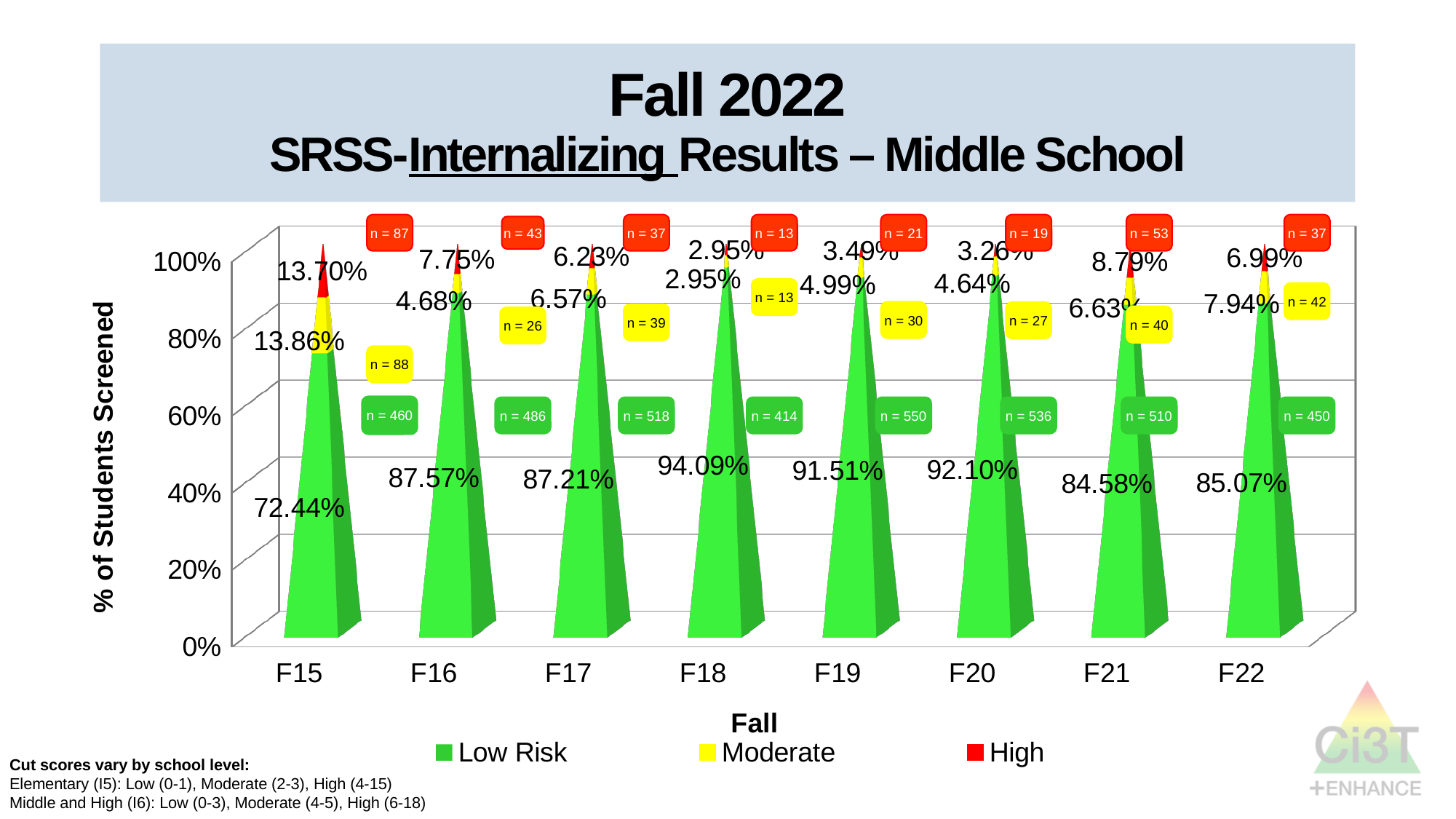
What is the Low Risk percentage for F18? 94.09% How many series does the legend list? 3 Which fall has the highest Low Risk percentage? F18 What is the title of the y axis? % of Students Screened What is the difference between the Low Risk percentages for F16 and F15? 15.13 percentage points What is the High percentage for F15? 13.70% How many fall screening periods are shown on the x axis? 8 What is the Moderate percentage for F15? 13.86% What kind of chart is shown on the slide? Stacked bar chart Which has a larger High percentage, F21 or F22? F21 What is the Low Risk percentage for F22? 85.07% Which fall has the lowest Low Risk percentage? F15